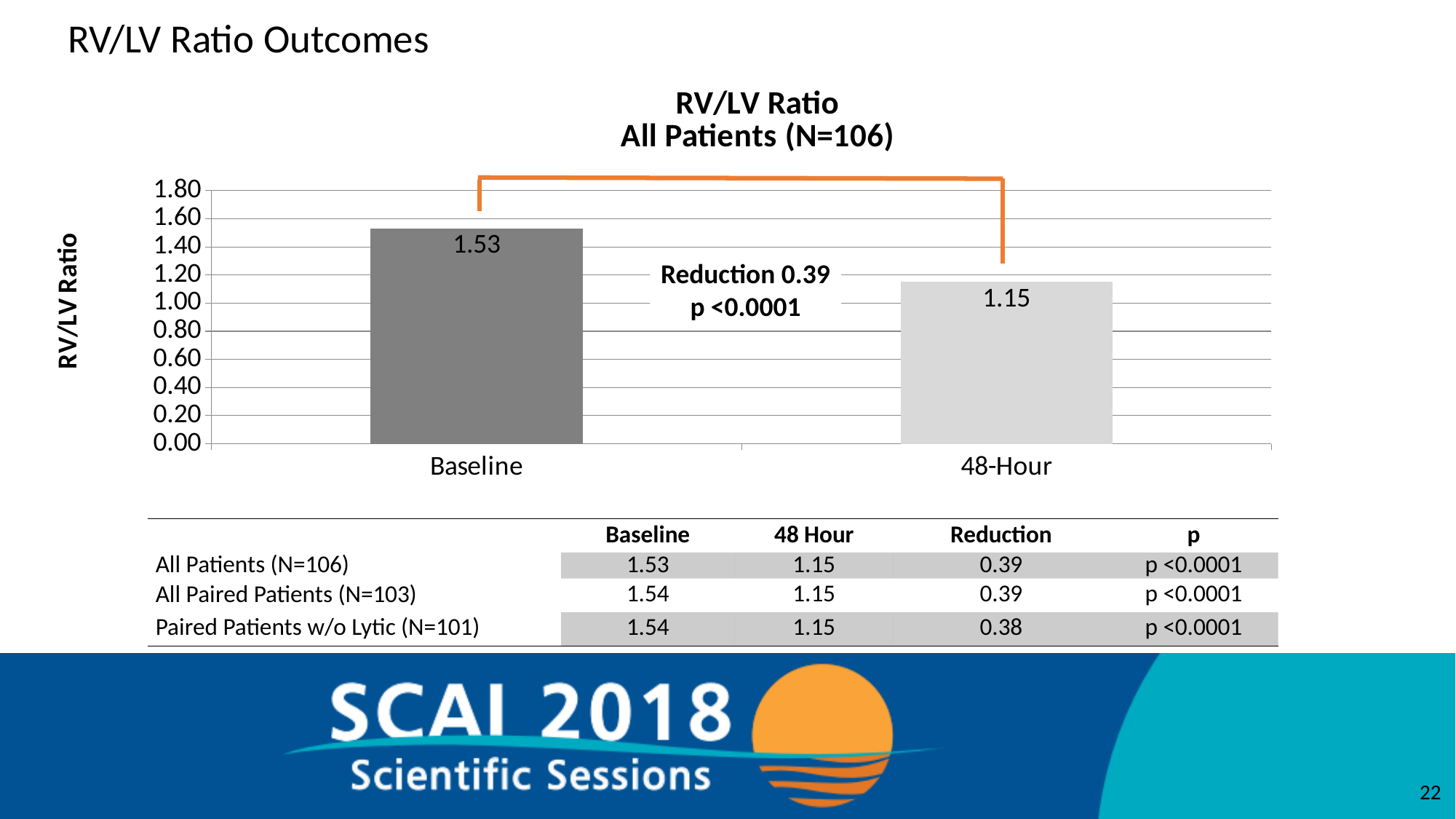
What is the title of the chart? RV/LV Ratio All Patients (N=106) Is the value for Baseline greater or less than 1.40? greater What kind of chart is shown on the slide? bar chart Which category has the higher RV/LV ratio, Baseline or 48-Hour? Baseline What is the difference between the Baseline and 48-Hour RV/LV ratio values? 0.38 How many categories are shown on the x axis of the chart? 2 Do the values rise or fall from Baseline to 48-Hour? fall Which category has the lowest RV/LV ratio in the chart? 48-Hour What is the RV/LV ratio value for Baseline in the chart? 1.53 Is the value for 48-Hour greater or less than 1.20? less What is the RV/LV ratio value for 48-Hour in the chart? 1.15 What is the label on the y axis of the chart? RV/LV Ratio